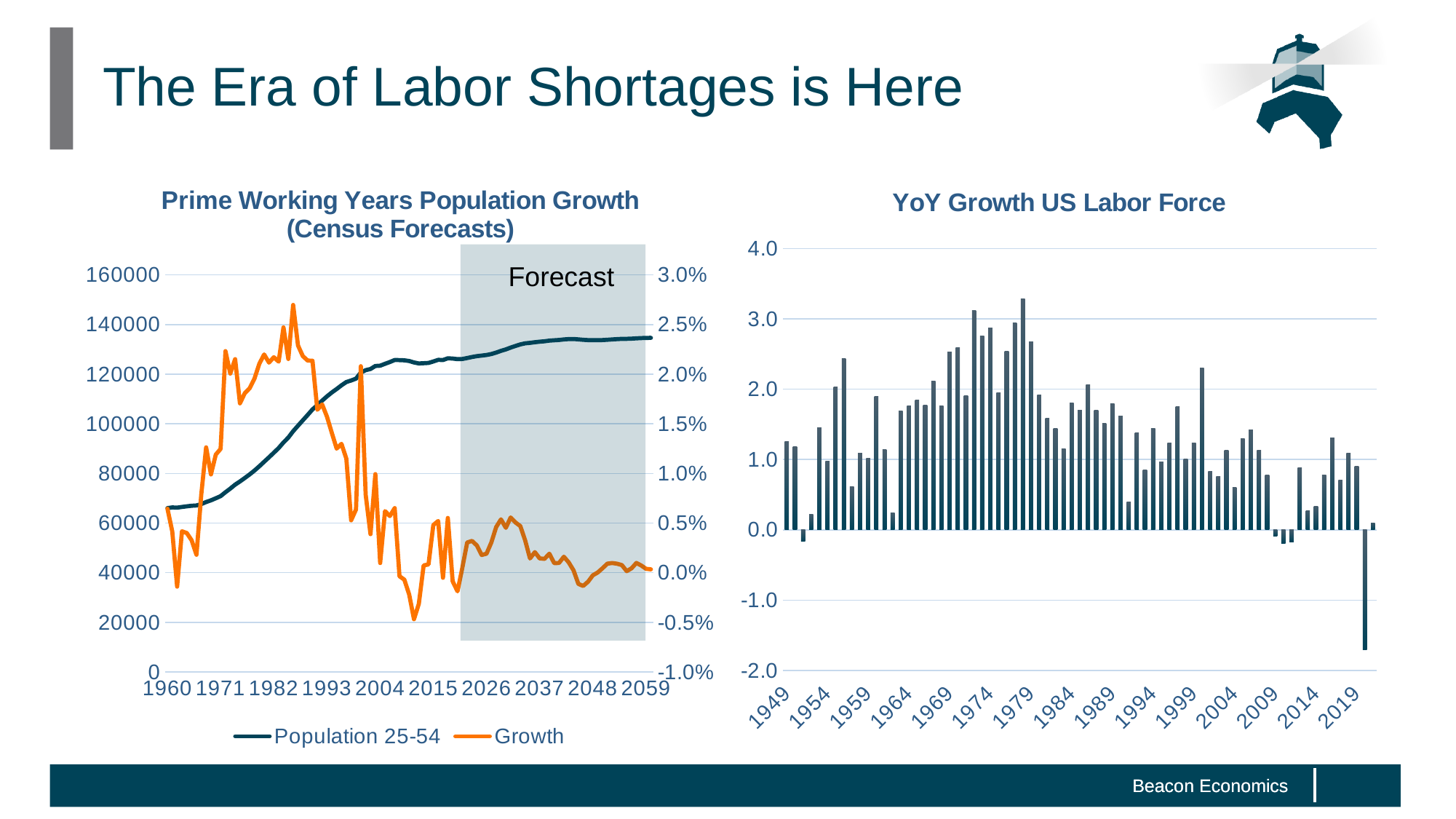
In the right chart, is the highest bar greater or less than 3.0? greater In the right chart, is the lowest bar (the last bar on the right) greater or less than -1.0? less What kind of chart is the 'YoY Growth US Labor Force' chart on the right? Bar chart In the left chart, is the Population 25-54 value for 2059 greater or less than 120000? greater In the left chart, what label is shown on the shaded region at the right side of the plot? Forecast What kind of chart is the 'Prime Working Years Population Growth (Census Forecasts)' chart on the left? Line chart How many series does the legend of the left chart list? 2 In the left chart, what are the two series named in the legend? Population 25-54 and Growth In the left chart, does the Population 25-54 series generally rise or fall from 1960 to 2059? Rise